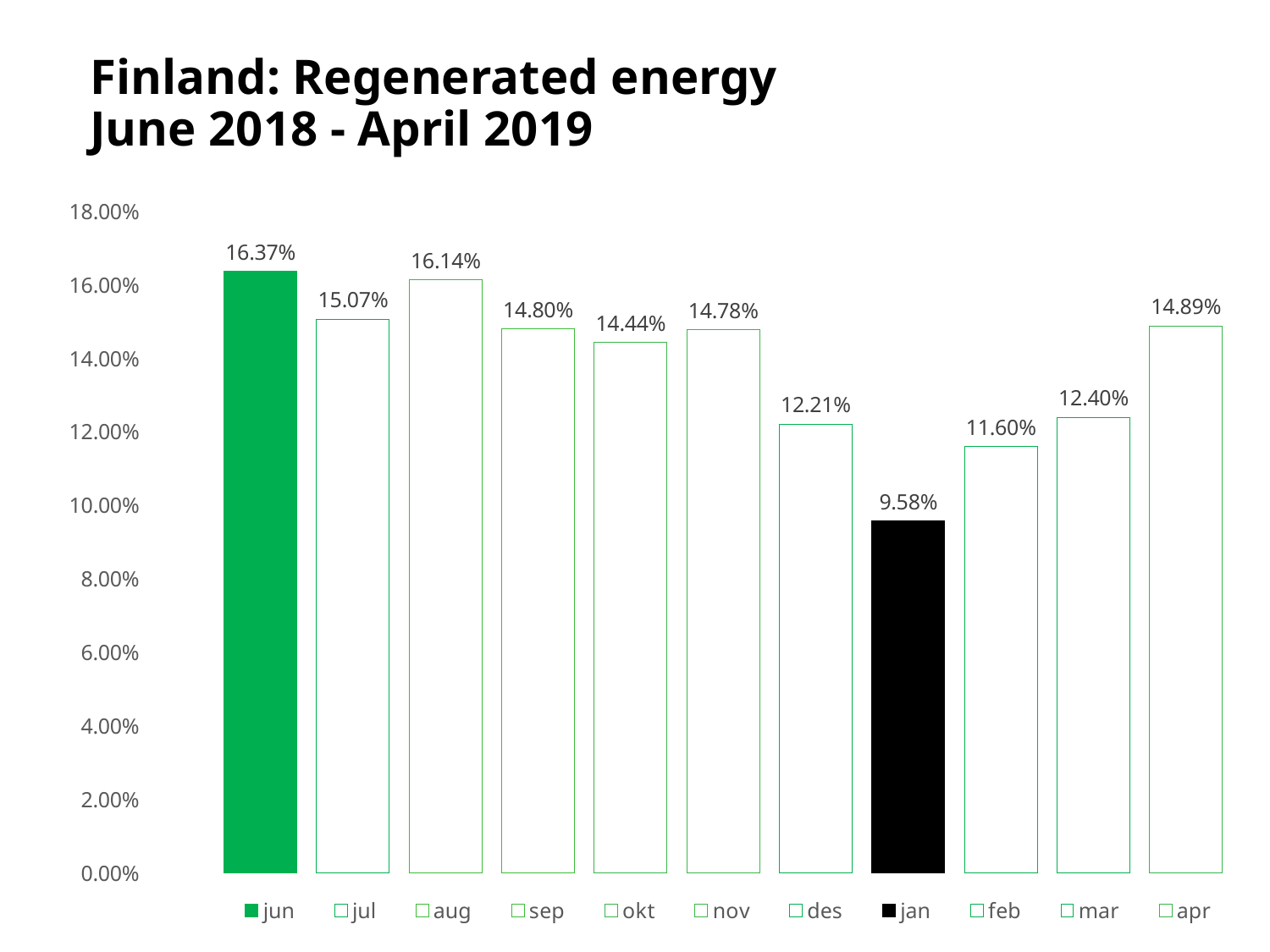
Which is larger, the value for aug or the value for apr? aug What kind of chart is shown on the slide? bar chart What is the value for des? 12.21% What is the value for jun? 16.37% Is the value for feb greater or less than 12.00%? less How many months are shown in the chart? 11 What is the value for jan? 9.58% What is the title of the chart? Finland: Regenerated energy June 2018 - April 2019 Which month has the lowest value? jan What is the difference between the values for jun and jan? 6.79% Which month has the highest value? jun